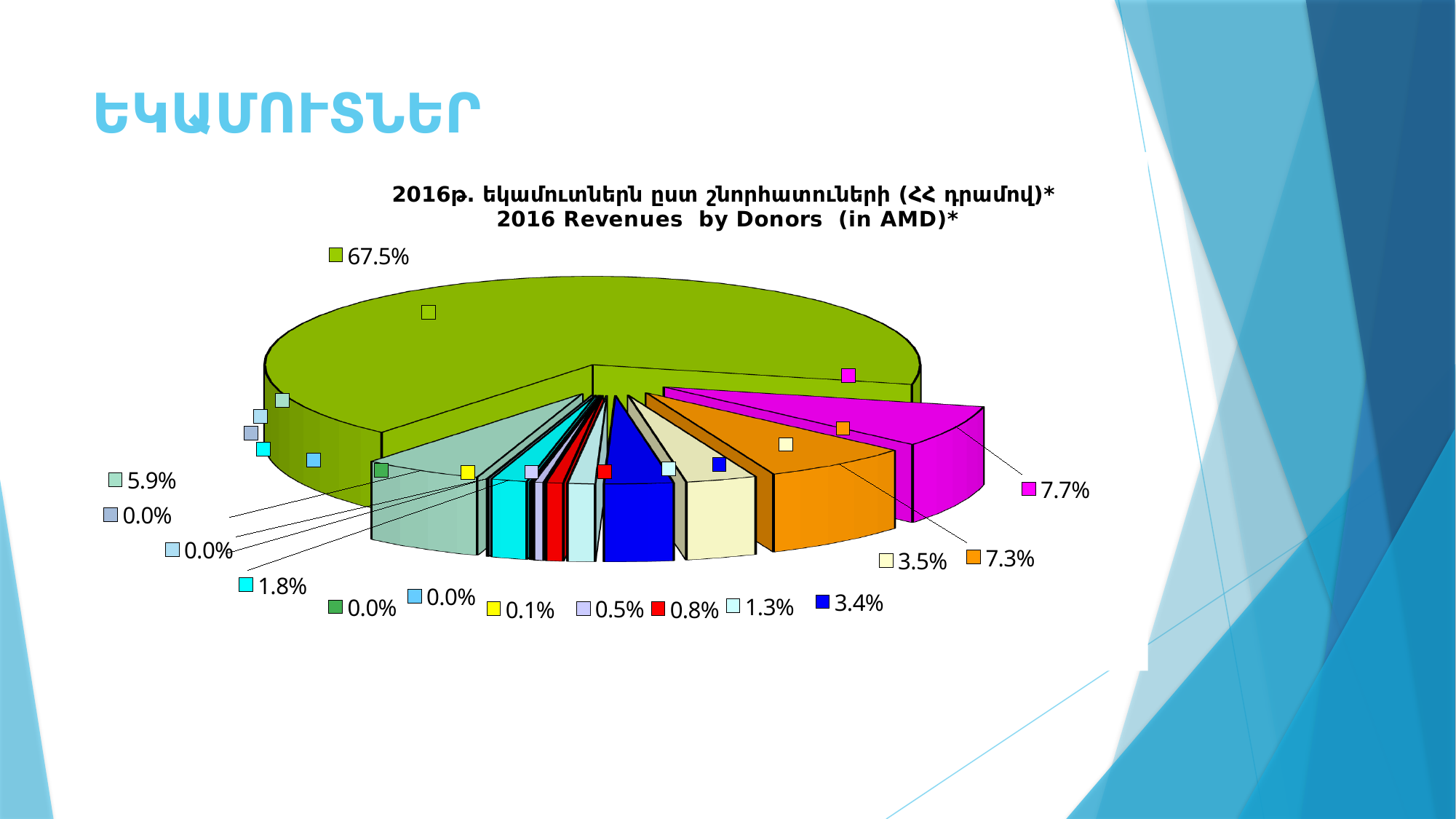
What percentage is labelled for the red slice? 0.8% What is the English title of the chart? 2016 Revenues by Donors (in AMD)* What is the largest share shown in the pie chart? 67.5% What percentage is labelled for the orange slice? 7.3% What percentage is labelled for the dark blue slice? 3.4% What percentage is labelled for the yellow slice? 0.1% What percentage is labelled for the magenta slice? 7.7% What kind of chart is shown on the slide? pie chart Which slice is larger, the magenta one or the orange one? magenta What is the difference between the largest slice (67.5%) and the magenta slice (7.7%)? 59.8% How many slices are labelled in the pie chart? 15 What is the difference between the magenta slice (7.7%) and the orange slice (7.3%)? 0.4%